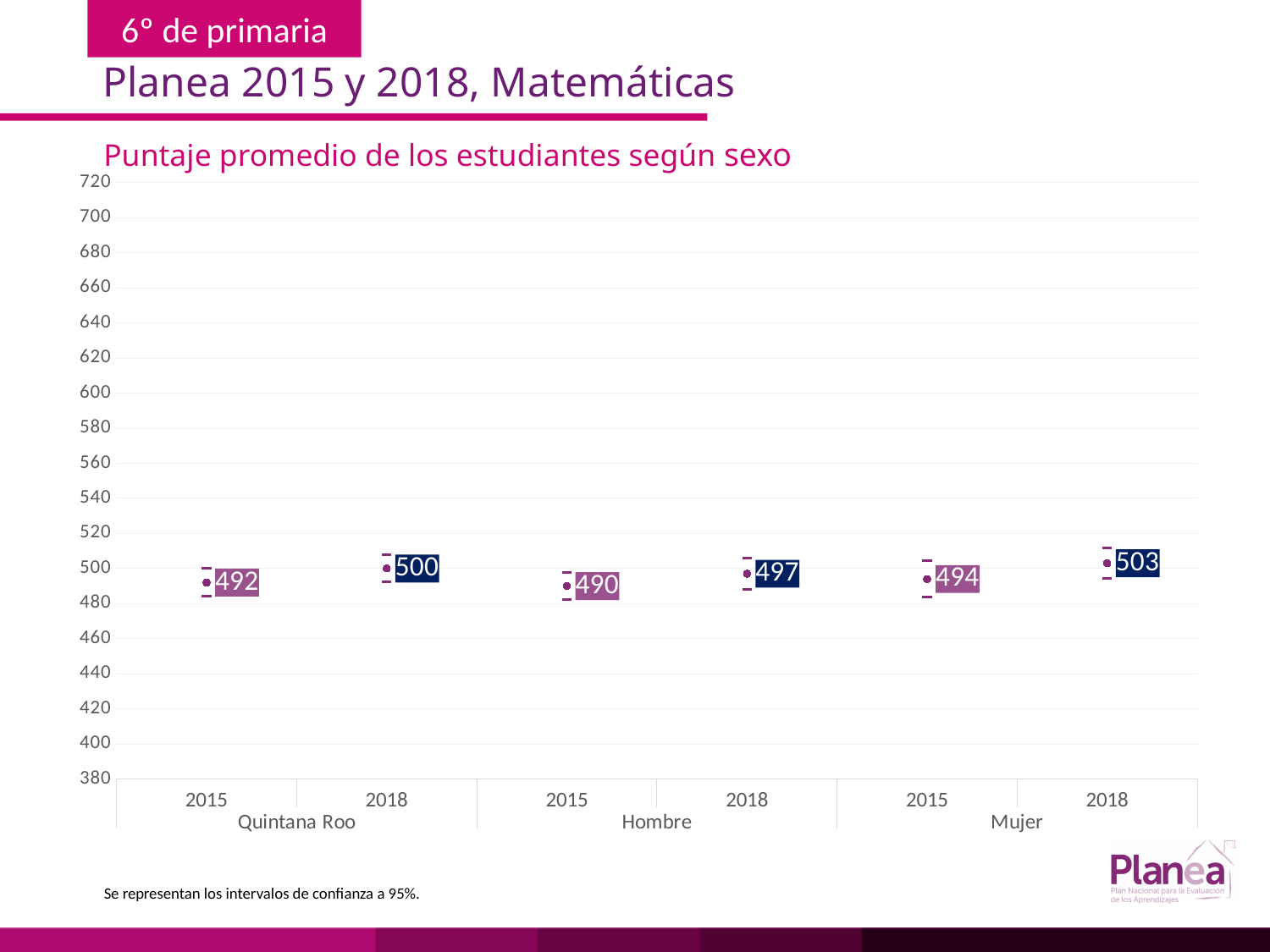
How many data points are plotted in the chart? 6 What is the 2018 value for Quintana Roo? 500 What is the difference between the 2018 and 2015 values for Mujer? 9 What is the title of the chart? Puntaje promedio de los estudiantes según sexo What is the difference between the 2018 and 2015 values for Quintana Roo? 8 Which group and year has the highest value? Mujer 2018 What is the 2015 value for Mujer? 494 Which is larger, the 2018 value for Hombre or the 2018 value for Mujer? Mujer 2018 Which group and year has the lowest value? Hombre 2015 Do the values rise or fall from 2015 to 2018 within each group? rise What is the 2018 value for Mujer? 503 What is the 2015 value for Hombre? 490